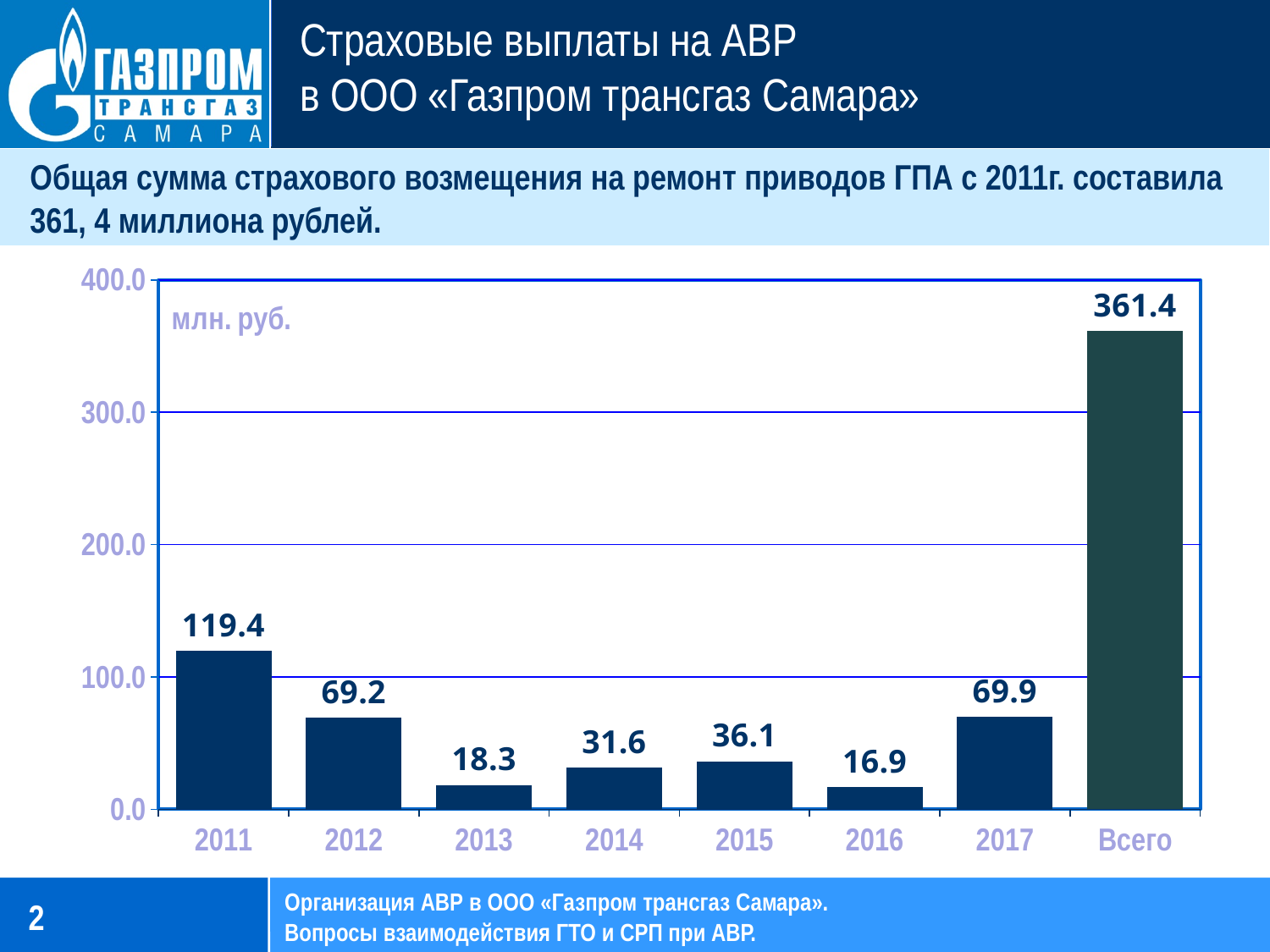
Do the values rise or fall from 2011 to 2013? fall What is the difference between the values for 2011 and 2012? 50.2 What is the value for 2011? 119.4 Which year has the lowest value? 2016 What is the value for 2016? 16.9 What is the value shown for the "Всего" bar? 361.4 Which year has the highest value? 2011 What kind of chart is shown on the slide? bar chart Is the value for 2017 greater or less than 100.0? less What unit is indicated in the top-left corner of the chart? млн. руб. How many bars are shown in the chart? 8 Which is larger, the value for 2015 or the value for 2014? 2015